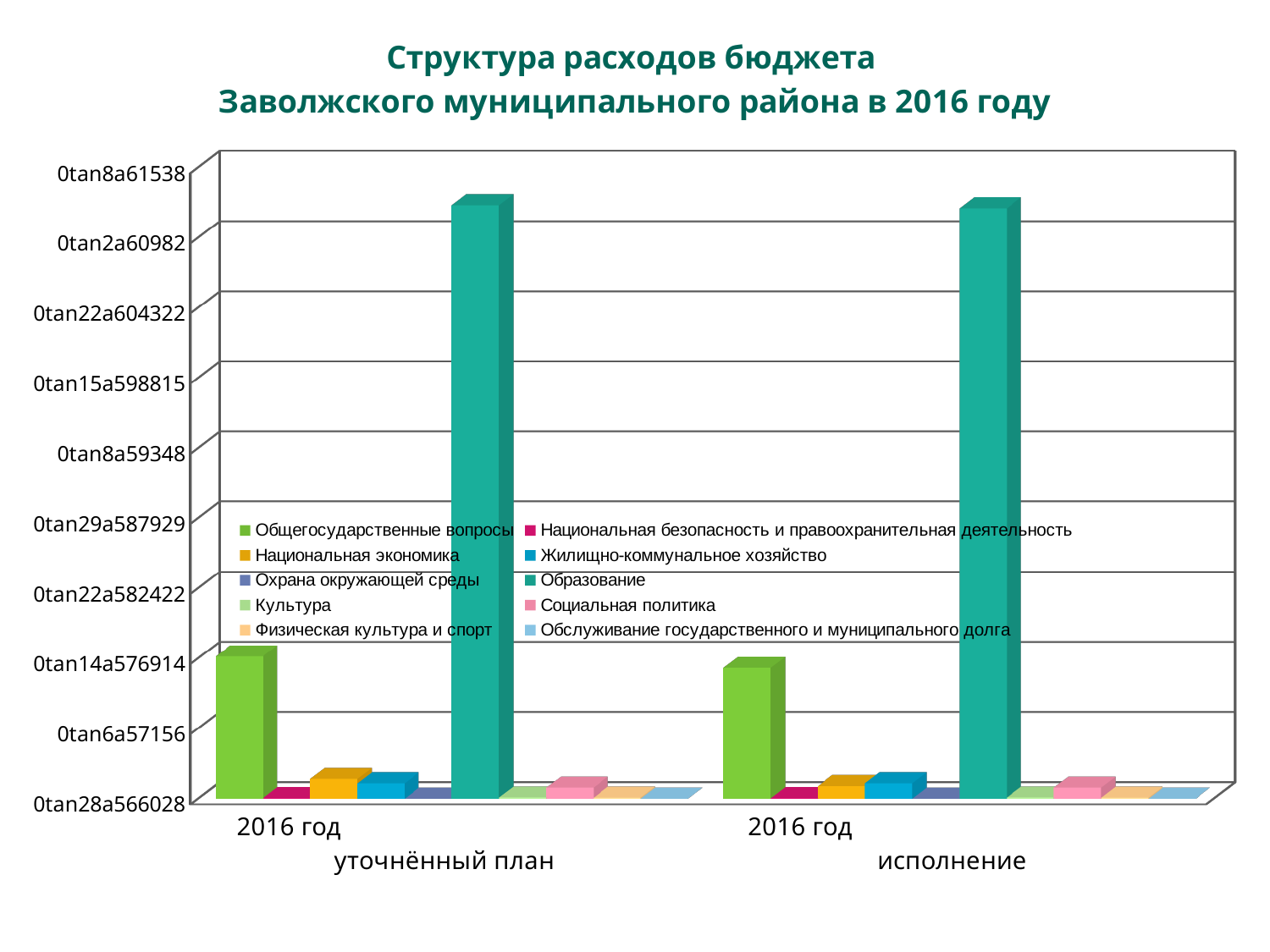
In the уточнённый план group, which is larger: Национальная экономика or Национальная безопасность и правоохранительная деятельность? Национальная экономика Which series has the second-highest bar in the исполнение group? Общегосударственные вопросы How many category groups are shown along the x axis? 2 Which series has the highest bar in the уточнённый план group? Образование In the уточнённый план group, which is larger: Образование or Общегосударственные вопросы? Образование What is the title of the chart? Структура расходов бюджета Заволжского муниципального района в 2016 году How many series does the legend list? 10 In the исполнение group, which is larger: Общегосударственные вопросы or Национальная экономика? Общегосударственные вопросы What are the two group labels shown below the x axis? уточнённый план and исполнение Which series has the highest bar in the исполнение group? Образование What kind of chart is shown on the slide? bar chart